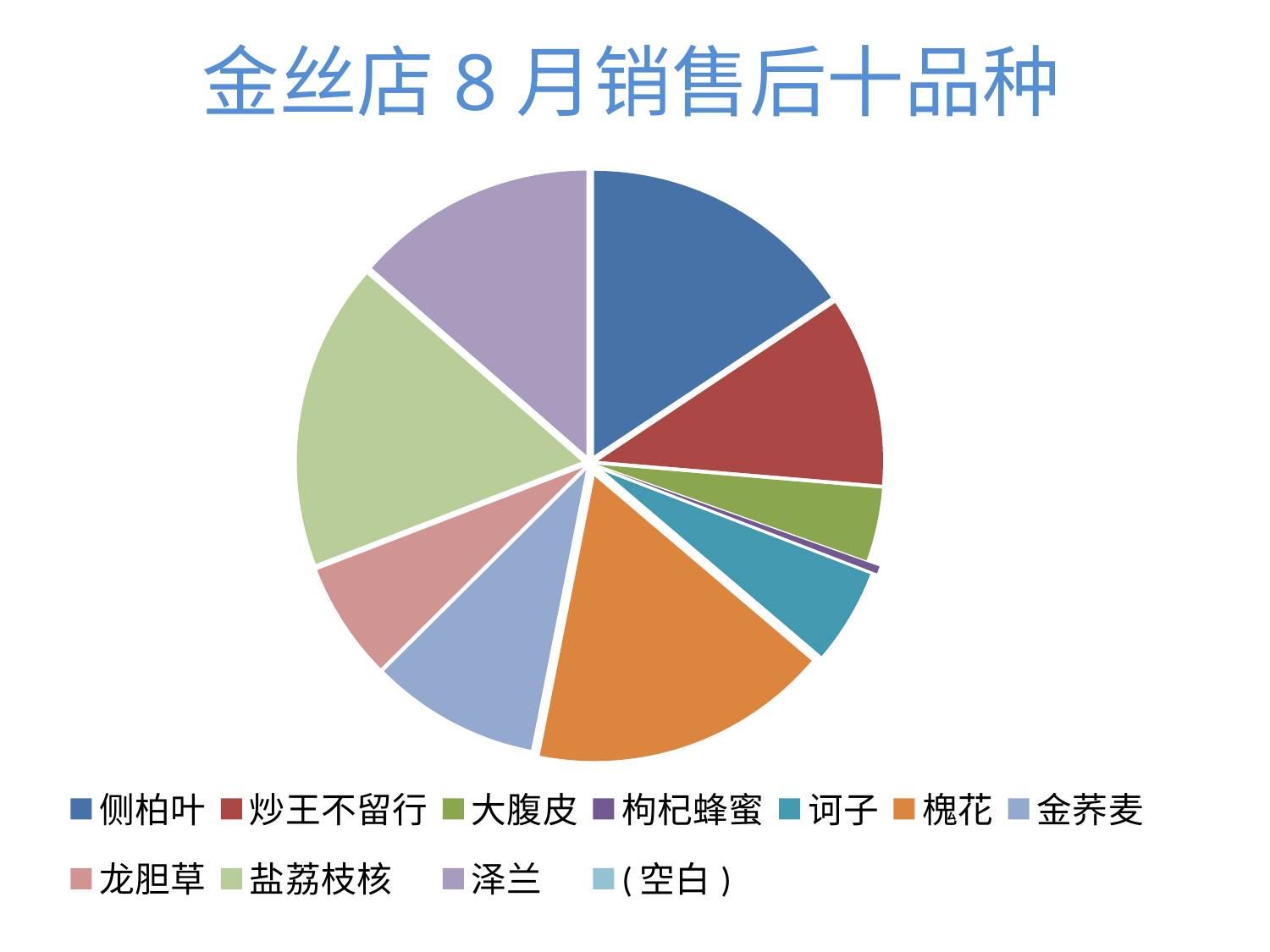
Which slice is larger, 金荞麦 or 大腹皮? 金荞麦 Which slice is larger, 泽兰 or 诃子? 泽兰 Which slice is larger, 炒王不留行 or 龙胆草? 炒王不留行 What is the title of the chart? 金丝店 8 月销售后十品种 How many categories does the legend list? 11 What colour is the 槐花 slice? orange Which category has the smallest visible slice in the pie? 枸杞蜂蜜 What kind of chart is shown on the slide? pie chart